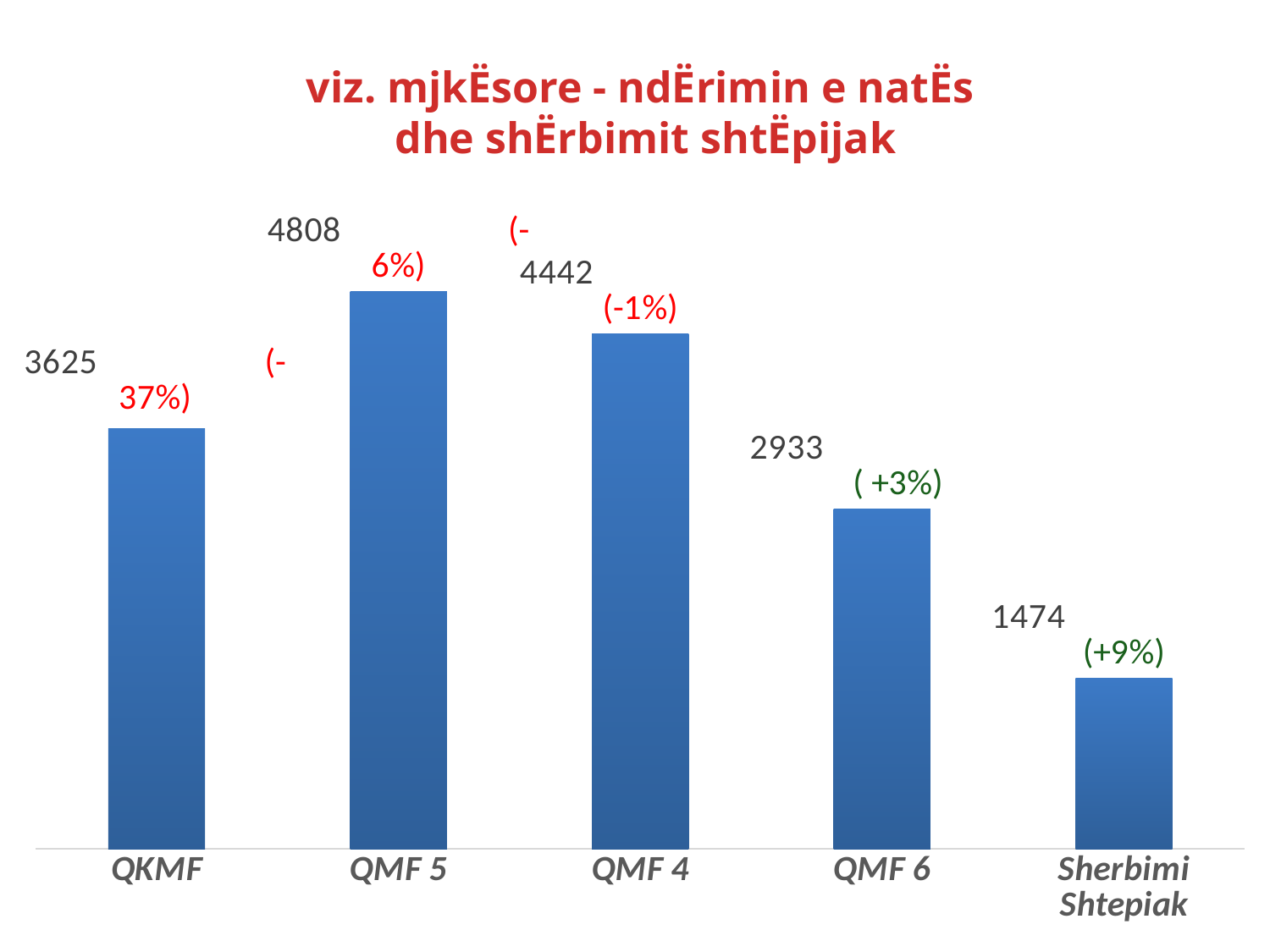
What is the value for QMF 5? 4808 What is the difference between the values for QMF 6 and Sherbimi Shtepiak? 1459 Which is larger, the value for QKMF or the value for QMF 4? QMF 4 What percentage change is shown next to the QMF 6 bar? +3% What is the value for Sherbimi Shtepiak? 1474 What is the value for QKMF? 3625 What is the value for QMF 6? 2933 What kind of chart is shown on the slide? Bar chart How many categories are shown on the x axis? 5 What is the difference between the values for QMF 5 and QMF 4? 366 Which category has the lowest value? Sherbimi Shtepiak Which category has the highest value? QMF 5